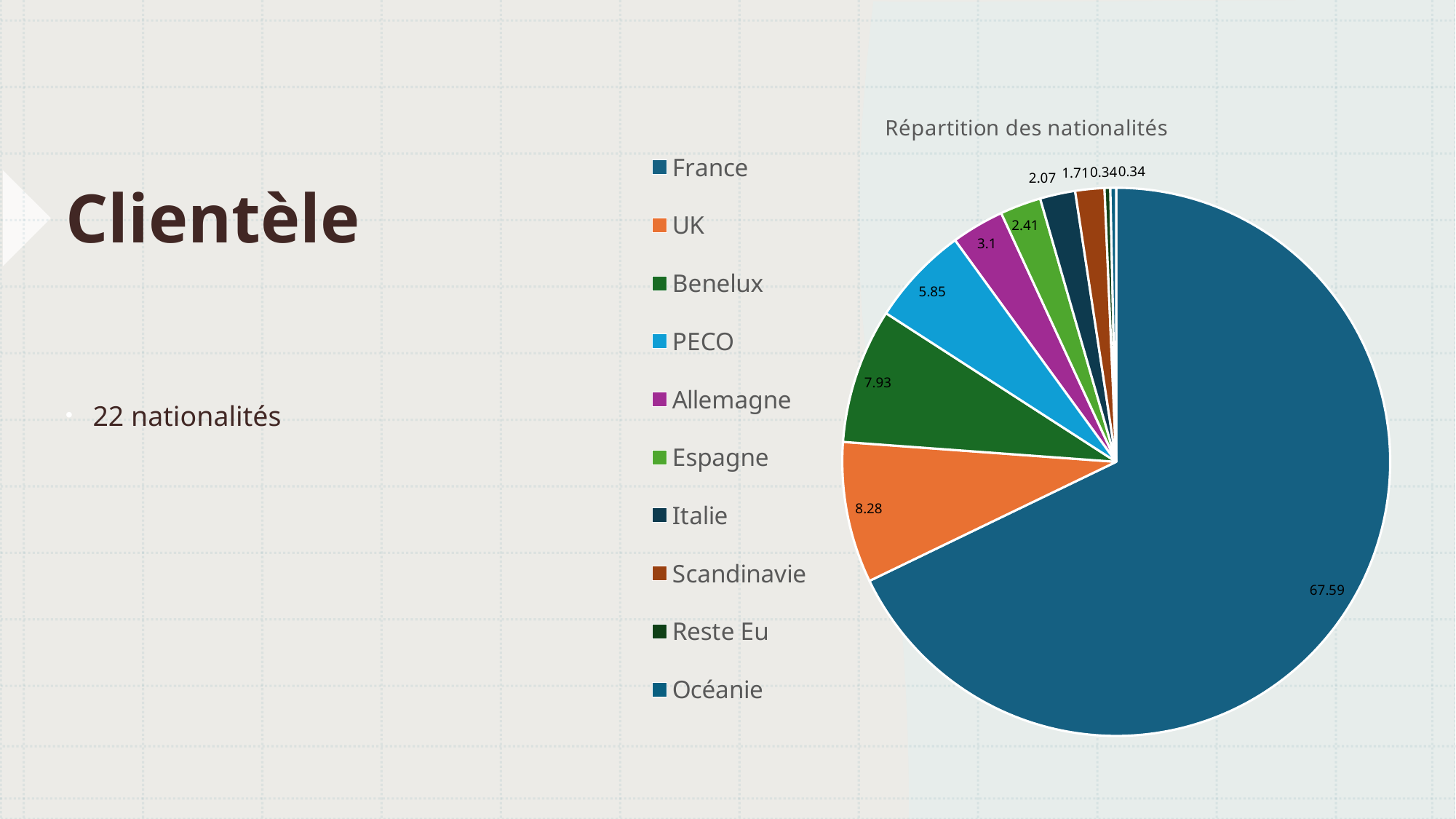
What is the value shown for Benelux in the pie chart? 7.93 What is the value shown for UK in the pie chart? 8.28 What is the title of the chart? Répartition des nationalités What is the value shown for PECO in the pie chart? 5.85 What is the value shown for Espagne in the pie chart? 2.41 What is the value shown for Allemagne in the pie chart? 3.1 What kind of chart is shown on the slide? pie chart What is the difference between the values for UK and Benelux? 0.35 How many categories does the legend of the pie chart list? 10 Which is larger, the value for PECO or the value for Allemagne? PECO Which category has the largest slice of the pie chart? France What is the value shown for France in the pie chart? 67.59